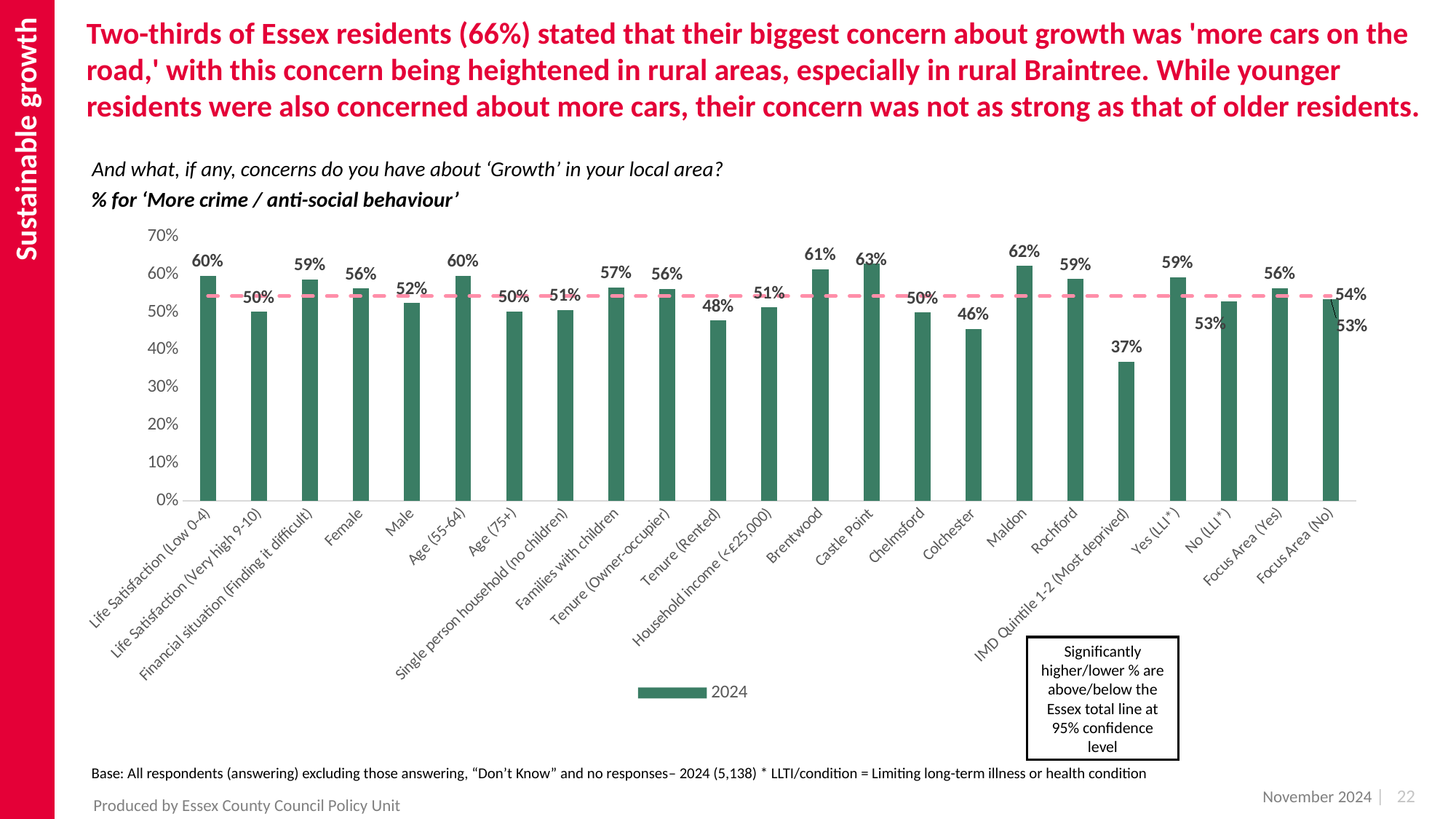
Which category has the highest value? Castle Point What is the value for IMD Quintile 1-2 (Most deprived)? 37% What kind of chart is shown on the slide? bar chart What is the difference between the values for Maldon and Colchester? 16% Is the value for Brentwood greater or less than 50%? greater What is the value for Tenure (Rented)? 48% What is the value for Castle Point? 63% How many categories are shown on the x axis? 23 What is the value for Age (55-64)? 60% Which category has the lowest value? IMD Quintile 1-2 (Most deprived) Which is larger, the value for Female or the value for Male? Female How many series does the legend list? 1